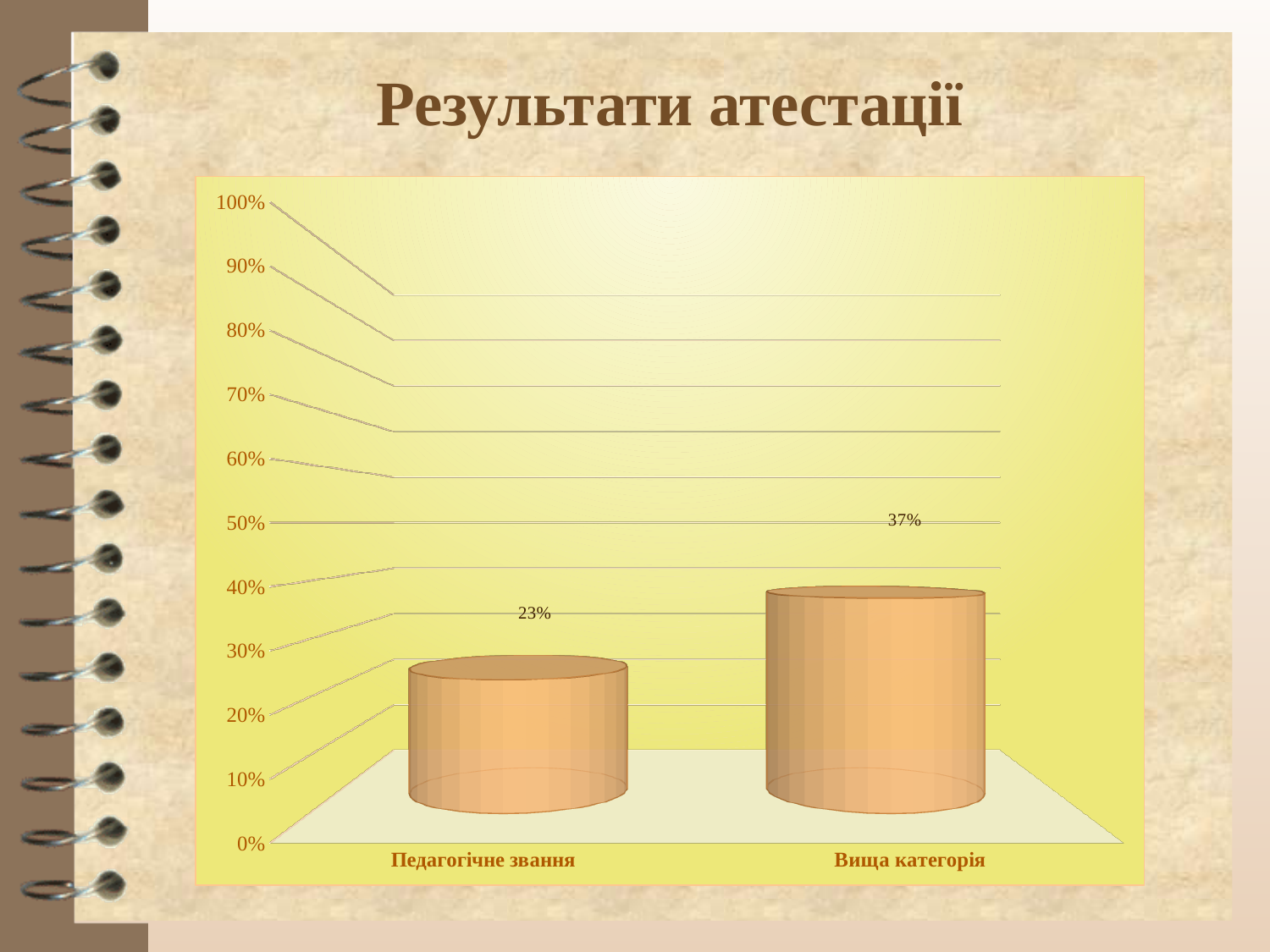
Which category has the highest value? Вища категорія Which is larger, the value for Педагогічне звання or the value for Вища категорія? Вища категорія What is the value for Вища категорія? 37% Is the value for Вища категорія greater or less than 50%? less What is the highest value shown on the vertical axis? 100% What is the value for Педагогічне звання? 23% Is the value for Педагогічне звання greater or less than 20%? greater What is the title of the slide? Результати атестації What is the difference between the values for Вища категорія and Педагогічне звання? 14% How many categories are shown in the chart? 2 What kind of chart is shown on the slide? bar chart Which category has the lowest value? Педагогічне звання